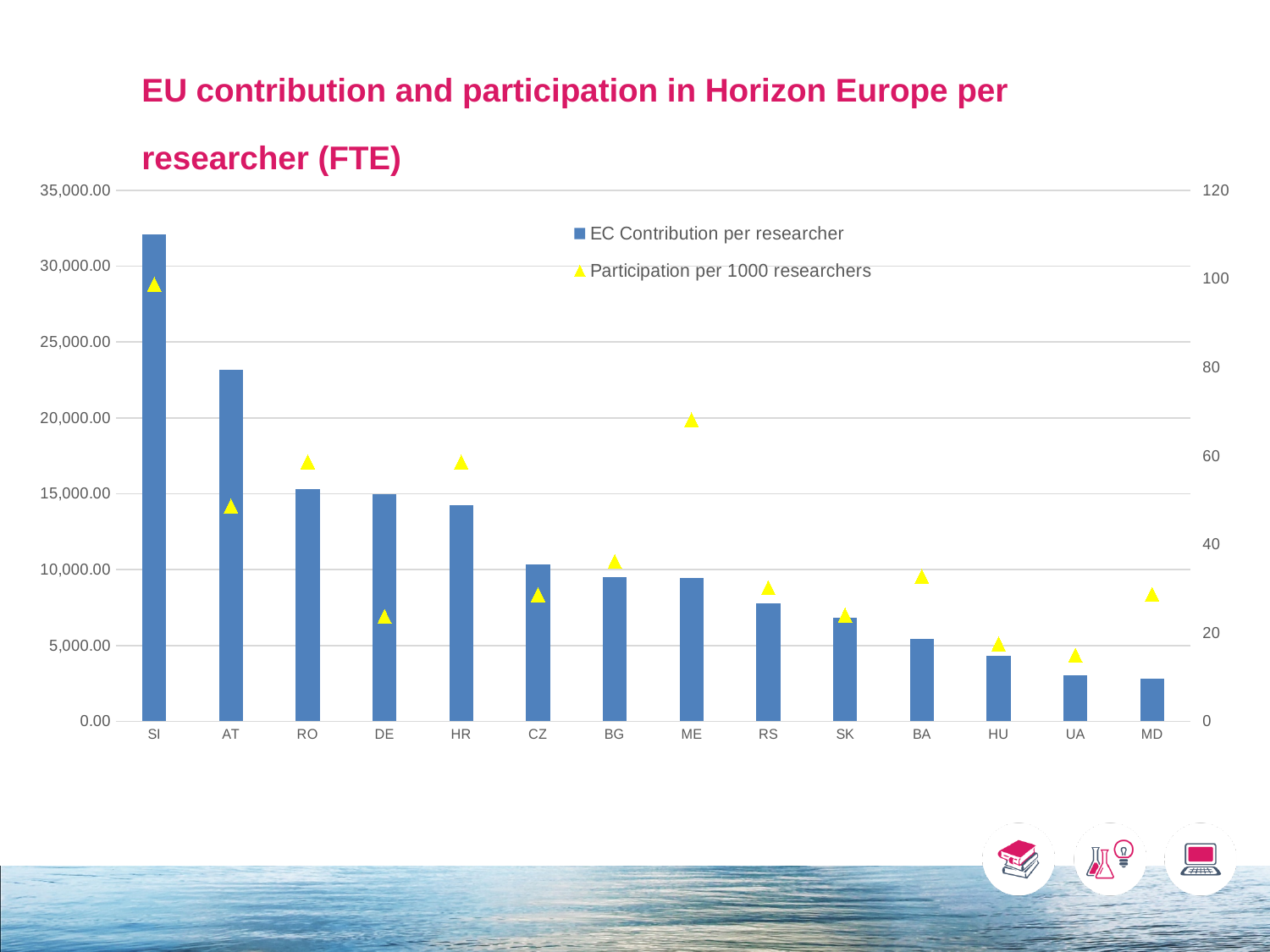
Which country has the lowest EC Contribution per researcher? MD Is the Participation per 1000 researchers for ME greater or less than 60? greater What marker shape and colour is used for the Participation per 1000 researchers series? Yellow triangles Do the EC Contribution per researcher bars rise or fall from left to right along the x axis? fall Is the EC Contribution per researcher for AT greater or less than 25,000.00? less How many series does the legend list? 2 Is the EC Contribution per researcher for SI greater or less than 30,000.00? greater Which country has the highest EC Contribution per researcher? SI What kind of chart is shown on the slide? Combination chart with bars and triangle markers (bar and line chart) Which has a larger EC Contribution per researcher, SI or AT? SI Which country has the highest Participation per 1000 researchers? SI How many countries are shown on the x axis? 14